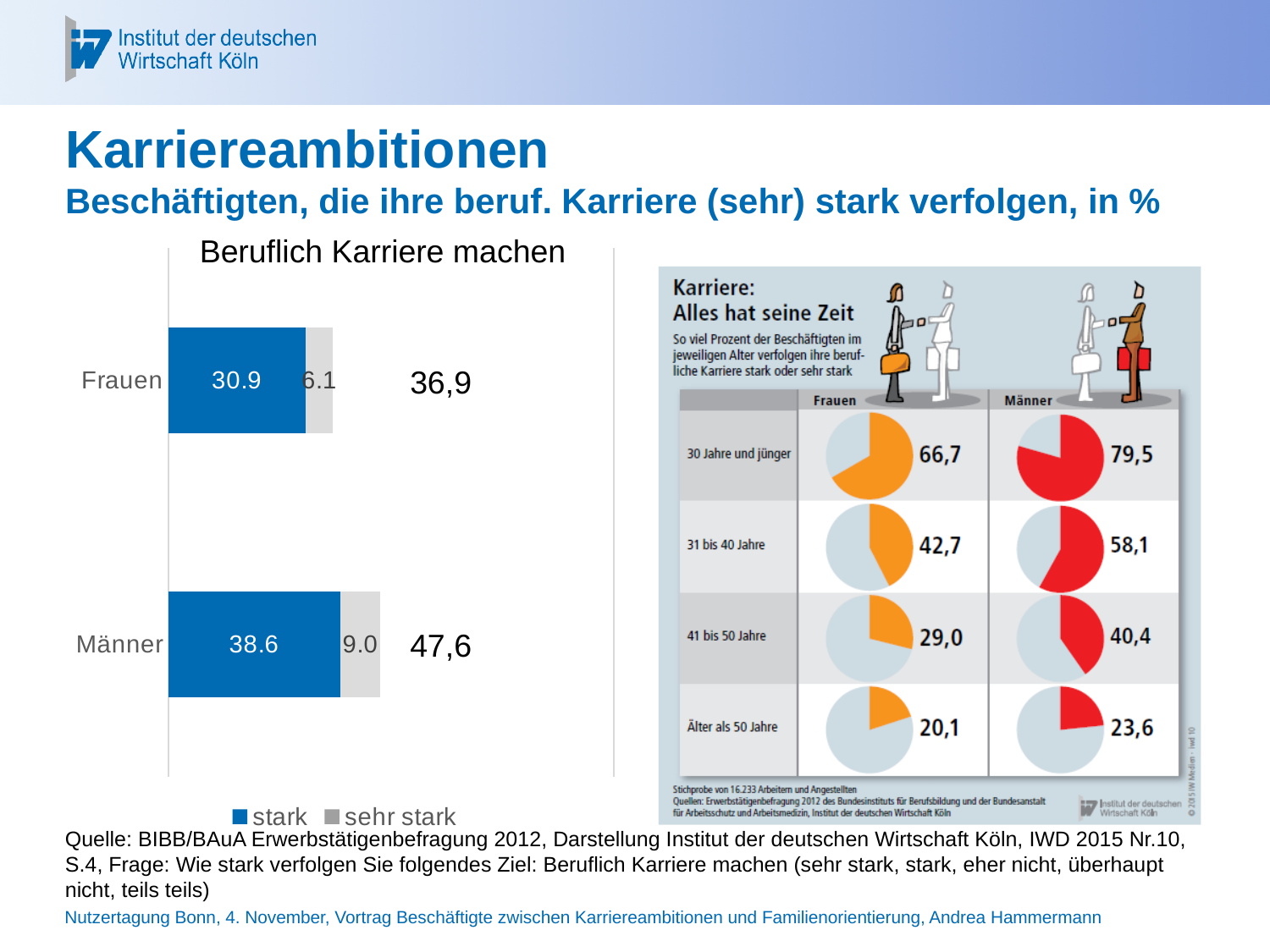
In the chart 'Beruflich Karriere machen', what is the total shown for the Frauen bar? 36,9 In the chart 'Beruflich Karriere machen', what is the value of 'sehr stark' for Männer? 9.0 In the chart 'Beruflich Karriere machen', how many series does the legend list? 2 In the chart 'Beruflich Karriere machen', what is the value of 'stark' for Frauen? 30.9 What kind of chart is 'Beruflich Karriere machen'? Stacked bar chart In the chart 'Karriere: Alles hat seine Zeit' on the right, what is the value for Frauen aged 41 bis 50 Jahre? 29,0 In the chart 'Beruflich Karriere machen', which group has the larger 'sehr stark' value, Frauen or Männer? Männer In the chart 'Karriere: Alles hat seine Zeit' on the right, do the values for Männer rise or fall as the age groups get older? Fall In the chart 'Karriere: Alles hat seine Zeit' on the right, what is the value for Männer aged 30 Jahre und jünger? 79,5 In the chart 'Beruflich Karriere machen', what is the difference between the 'stark' values for Männer and Frauen? 7.7 In the chart 'Beruflich Karriere machen', what is the total shown for the Männer bar? 47,6 In the chart 'Karriere: Alles hat seine Zeit' on the right, which age group has the lowest value for Frauen? Älter als 50 Jahre